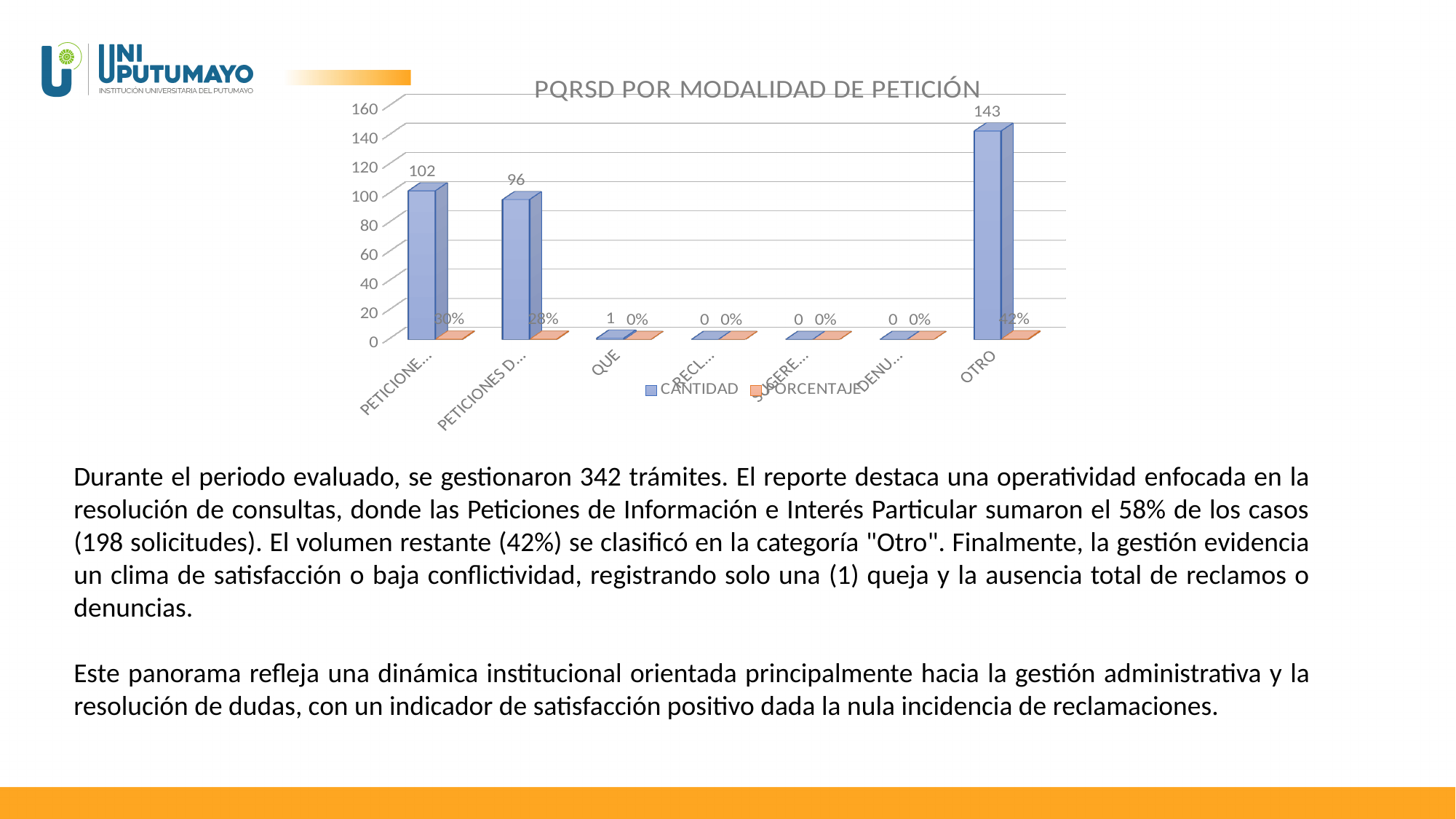
Is the CANTIDAD value for OTRO greater or less than 120? greater What is the CANTIDAD value for the OTRO category? 143 How many series does the legend list? 2 What is the difference between the CANTIDAD value for OTRO and the CANTIDAD value for the first category from the left? 41 What is the PORCENTAJE value for the OTRO category? 42% What is the CANTIDAD value for the first category from the left? 102 What kind of chart is shown on the slide? bar chart Which category has the highest CANTIDAD value? OTRO What are the two series named in the legend? CANTIDAD and PORCENTAJE What is the title of the chart? PQRSD POR MODALIDAD DE PETICIÓN How many categories are shown on the x axis? 7 Which has a larger CANTIDAD value: OTRO or the second category from the left? OTRO